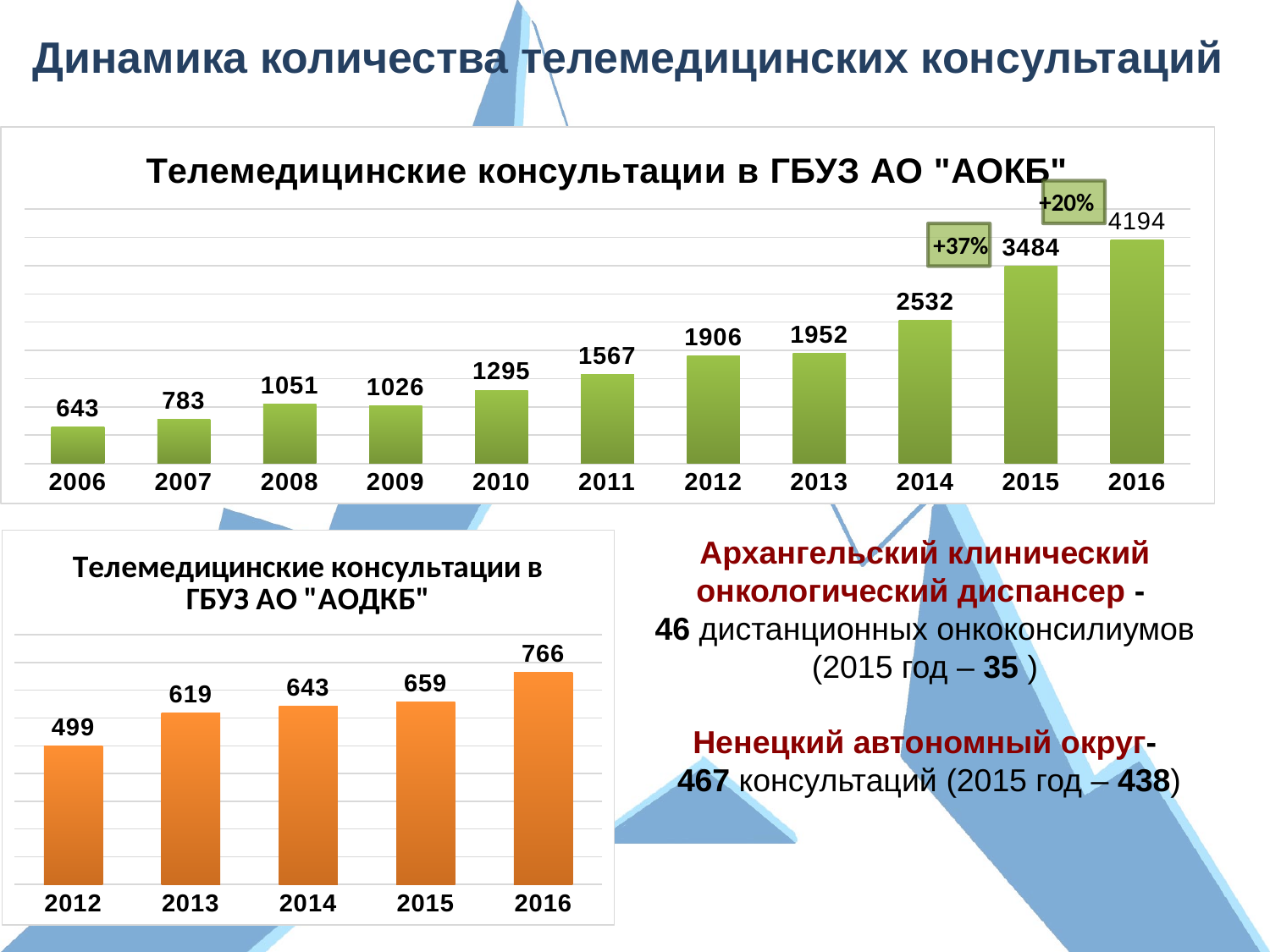
In the chart "Телемедицинские консультации в ГБУЗ АО "АОДКБ"", do the values rise or fall from 2012 to 2016? rise In the chart "Телемедицинские консультации в ГБУЗ АО "АОКБ"", which year has the lowest value? 2006 In the chart "Телемедицинские консультации в ГБУЗ АО "АОКБ"", what is the difference between the values for 2016 and 2015? 710 In the chart "Телемедицинские консультации в ГБУЗ АО "АОКБ"", what is the value for 2014? 2532 How many years are shown in the chart "Телемедицинские консультации в ГБУЗ АО "АОКБ""? 11 In the chart "Телемедицинские консультации в ГБУЗ АО "АОДКБ"", what is the difference between the values for 2016 and 2012? 267 In the chart "Телемедицинские консультации в ГБУЗ АО "АОКБ"", which year has the highest value? 2016 In the chart "Телемедицинские консультации в ГБУЗ АО "АОДКБ"", which year has the highest value? 2016 In the chart "Телемедицинские консультации в ГБУЗ АО "АОКБ"", which is larger, the value for 2008 or the value for 2009? 2008 What type of chart is "Телемедицинские консультации в ГБУЗ АО "АОКБ""? bar chart In the chart "Телемедицинские консультации в ГБУЗ АО "АОКБ"", what percentage growth label is shown above the 2015 bar? +37% In the chart "Телемедицинские консультации в ГБУЗ АО "АОДКБ"", what is the value for 2013? 619